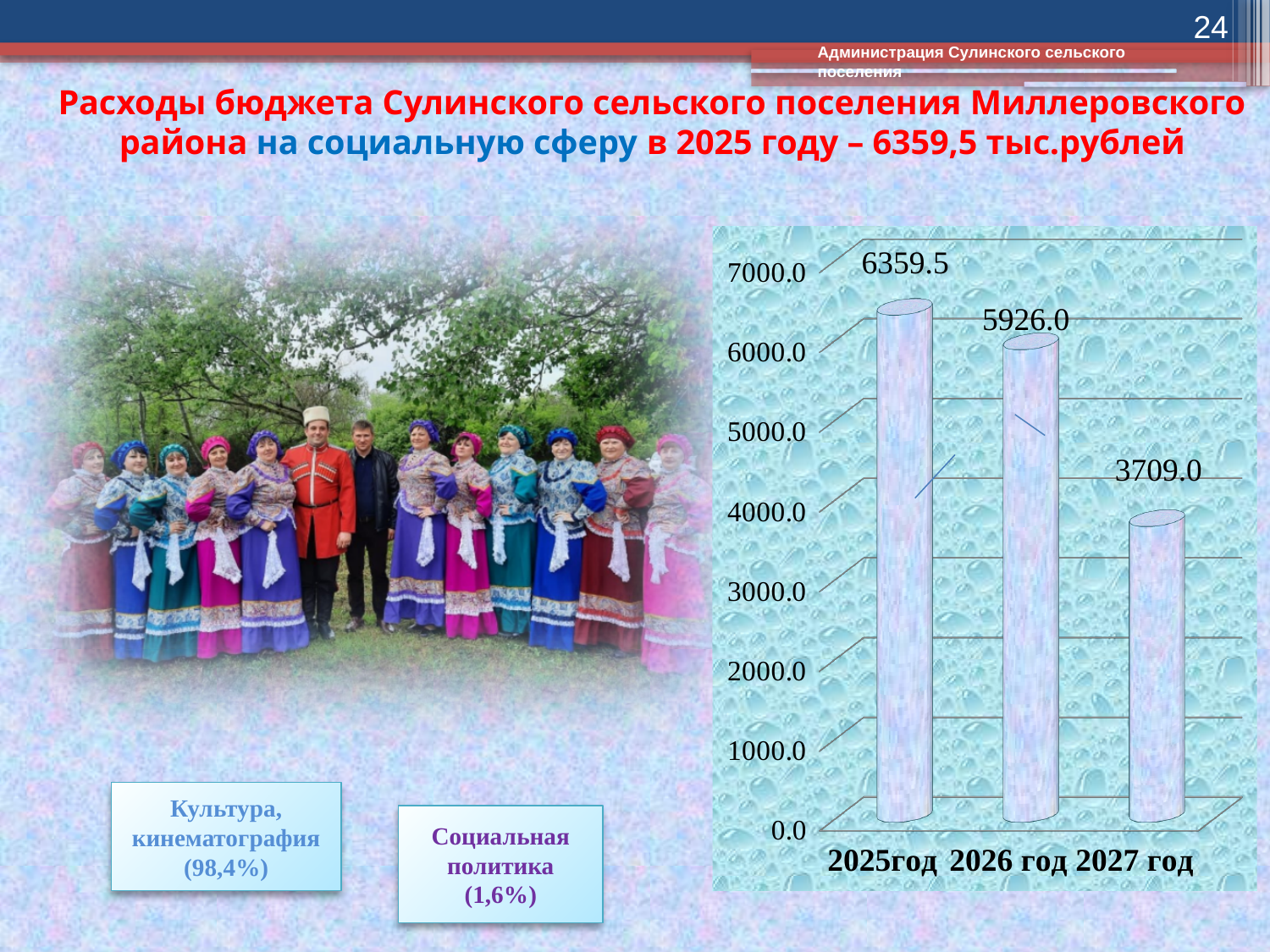
Which year has the lowest value? 2027 год Is the value for 2027 год greater or less than 4000.0? less What is the value for 2026 год? 5926.0 Which is larger, the value for 2026 год or the value for 2027 год? 2026 год What kind of chart is shown on the slide? bar chart What is the value for 2027 год? 3709.0 How many years are shown on the chart? 3 Which year has the highest value? 2025 год What is the difference between the values for 2025 год and 2027 год? 2650.5 What is the value for 2025 год? 6359.5 What is the difference between the values for 2025 год and 2026 год? 433.5 Do the values rise or fall from 2025 год to 2027 год? fall